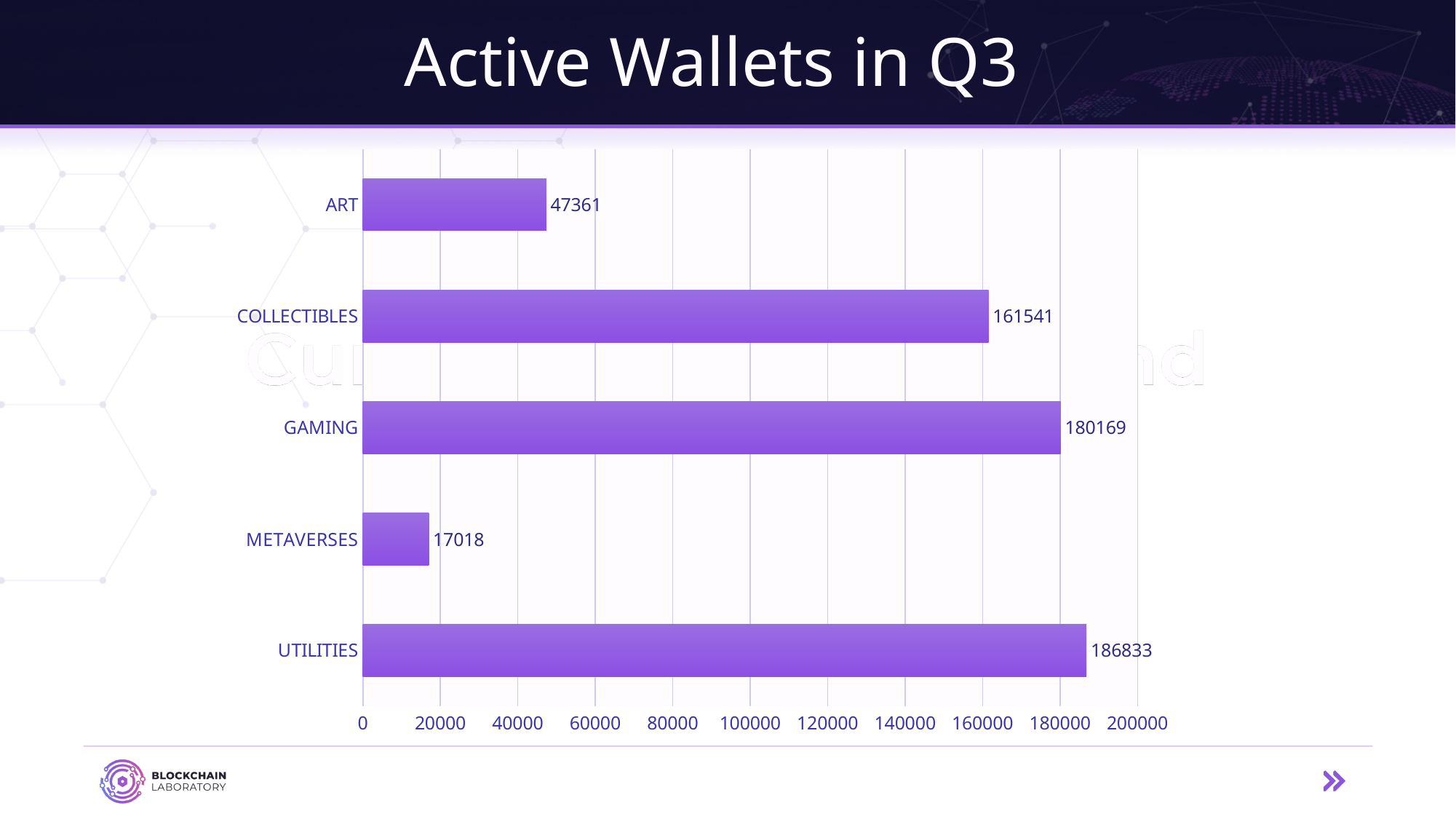
What is the value for GAMING? 180169 Which category has the lowest value? METAVERSES Is the value for COLLECTIBLES greater or less than 140000? greater What is the difference between the values for COLLECTIBLES and ART? 114180 What is the difference between the values for UTILITIES and GAMING? 6664 How many categories are shown in the chart? 5 What is the value for METAVERSES? 17018 What is the value for ART? 47361 What is the title of the chart? Active Wallets in Q3 Which is larger, the value for COLLECTIBLES or the value for GAMING? GAMING What kind of chart is shown on the slide? bar chart Which category has the highest value? UTILITIES